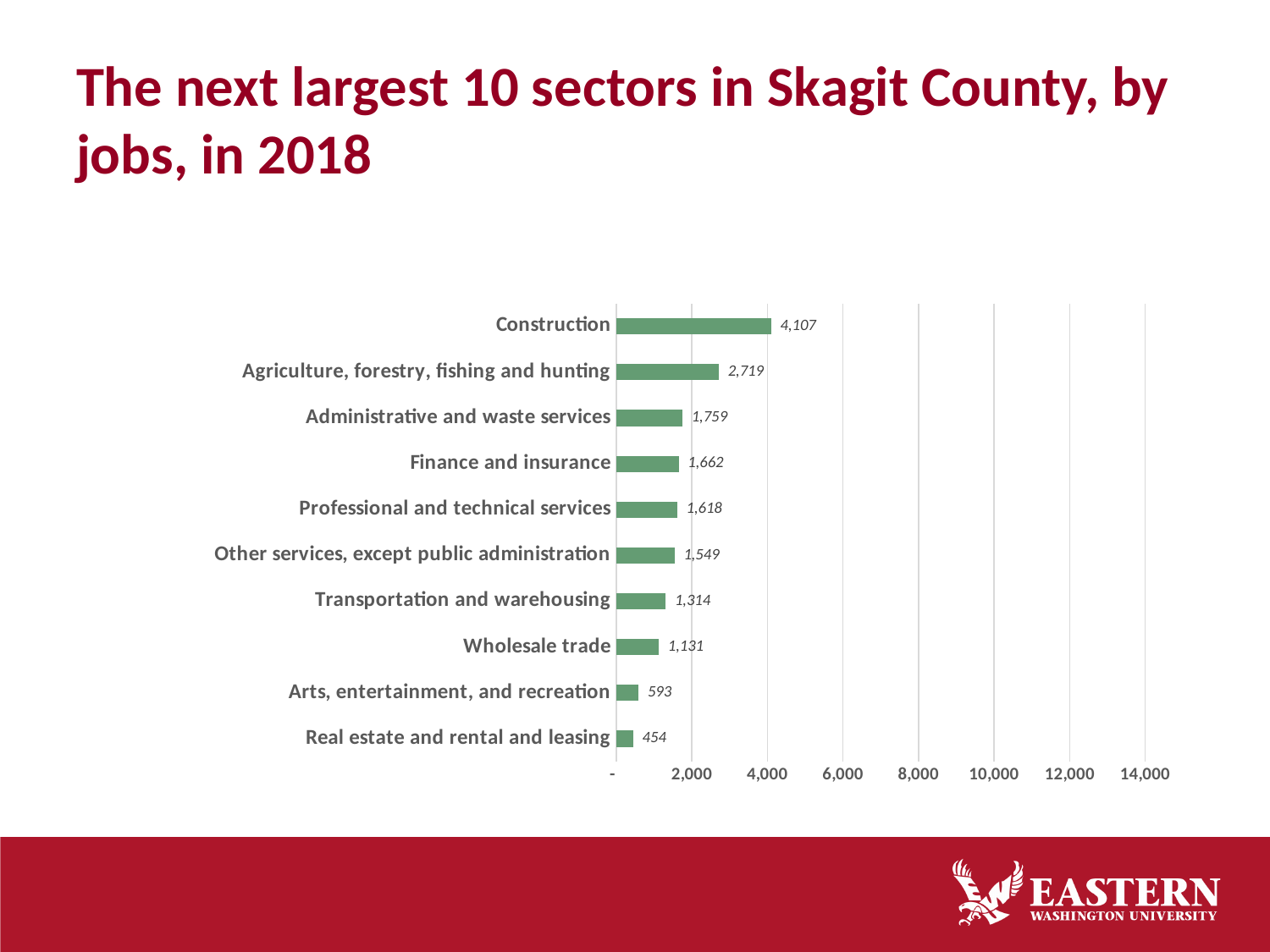
What is the value for Transportation and warehousing? 1,314 Is the value for Agriculture, forestry, fishing and hunting greater or less than 2,000? greater Which has more jobs, Finance and insurance or Wholesale trade? Finance and insurance What is the difference in jobs between Construction and Agriculture, forestry, fishing and hunting? 1,388 Which sector has the lowest number of jobs? Real estate and rental and leasing How many sectors are shown in the chart? 10 What is the highest value shown on the horizontal axis? 14,000 What type of chart is shown on the slide? Bar chart How many jobs does the Construction sector have? 4,107 Which sector has the highest number of jobs? Construction What is the value for Wholesale trade? 1,131 What is the difference between Arts, entertainment, and recreation and Real estate and rental and leasing? 139